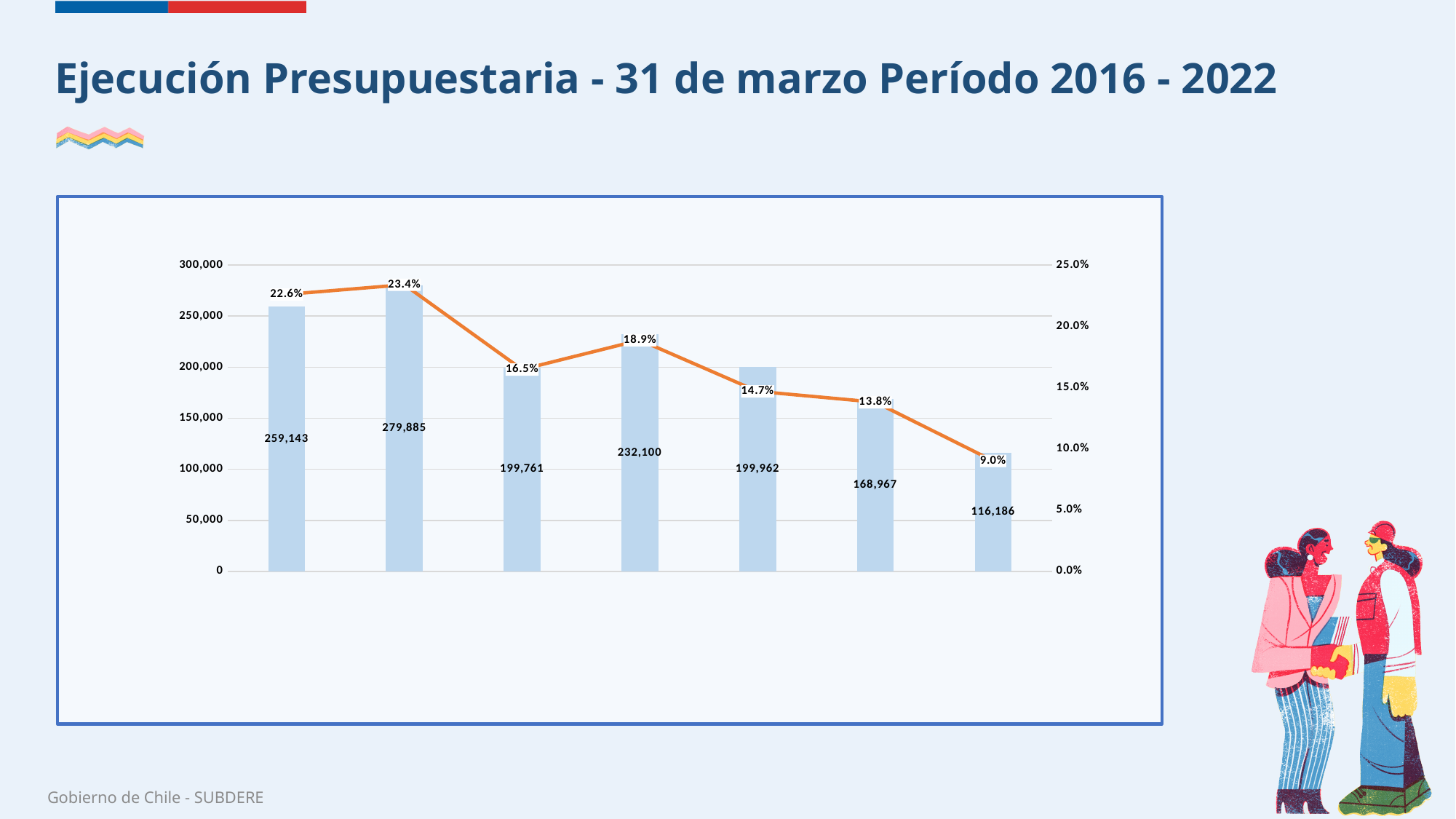
Which is larger, the first bar or the fourth bar? The first bar (259,143) Does the percentage line generally rise or fall from left to right? Fall What is the difference between the second bar (279,885) and the first bar (259,143)? 20,742 What is the maximum value shown on the right-hand percentage axis? 25.0% What type of chart is shown on the slide? A combination bar and line chart What is the value labelled on the last (rightmost) bar? 116,186 What is the difference between the sixth bar (168,967) and the seventh bar (116,186)? 52,781 What is the value labelled on the second bar from the left? 279,885 Which bar has the highest value, and what is it? The second bar, 279,885 What is the lowest percentage shown on the line? 9.0% How many bars are plotted in the chart? 7 What percentage is labelled on the line at the fourth point from the left? 18.9%